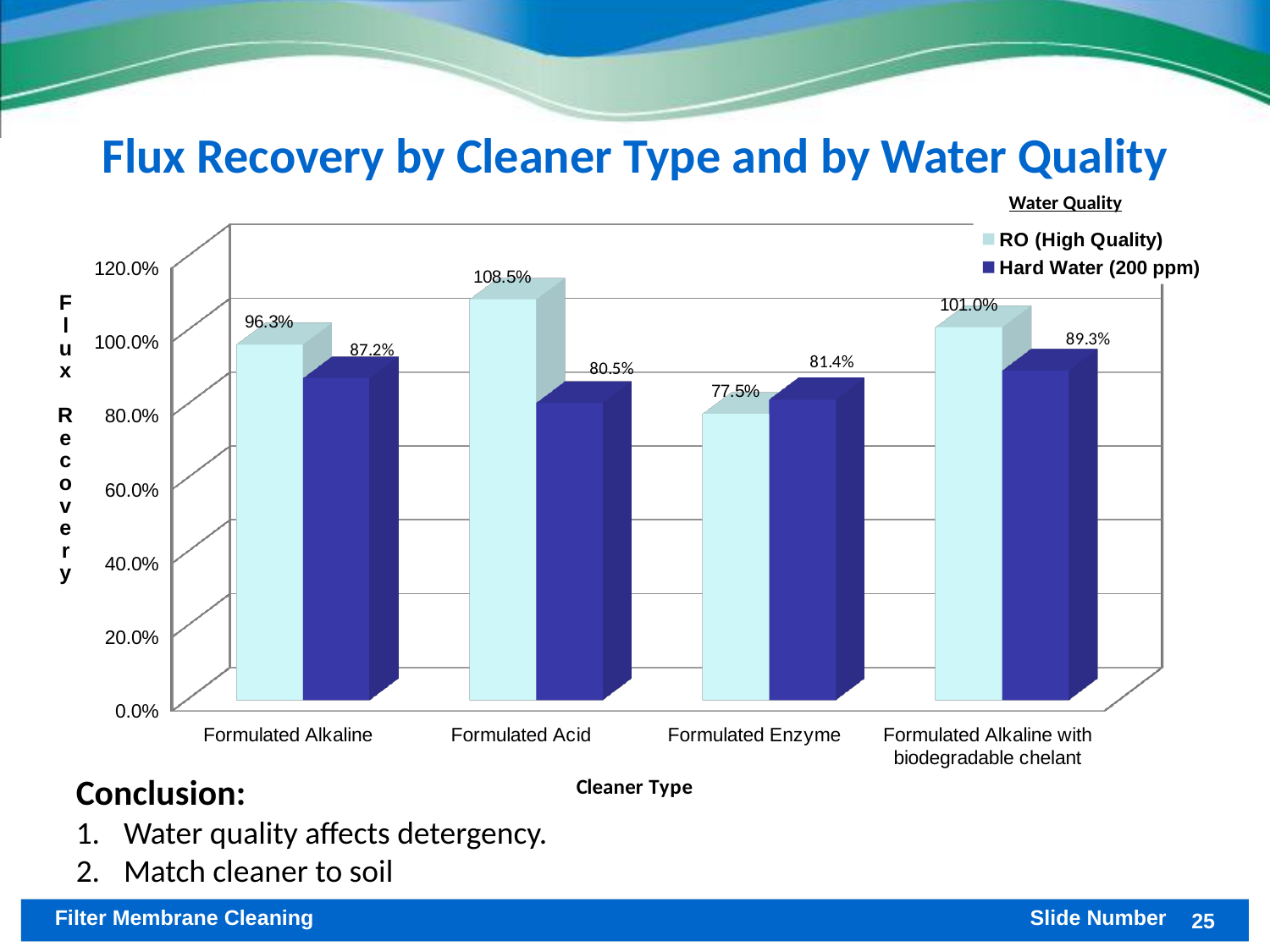
What is the flux recovery for Formulated Acid with RO (High Quality) water? 108.5% Which cleaner type has the highest flux recovery with RO (High Quality) water? Formulated Acid Which cleaner type has the lowest flux recovery with Hard Water (200 ppm)? Formulated Acid Is the flux recovery for Formulated Alkaline with Hard Water (200 ppm) greater or less than 80.0%? greater For Formulated Enzyme, which water quality gives the higher flux recovery? Hard Water (200 ppm) How many cleaner types are shown on the x axis? 4 How many series does the legend list? 2 What is the difference between the RO (High Quality) and Hard Water (200 ppm) flux recovery for Formulated Acid? 28.0% What is the flux recovery for Formulated Enzyme with Hard Water (200 ppm)? 81.4% What is the flux recovery for Formulated Alkaline with biodegradable chelant with RO (High Quality) water? 101.0% What is the title of the chart? Flux Recovery by Cleaner Type and by Water Quality What kind of chart is shown on the slide? Bar chart